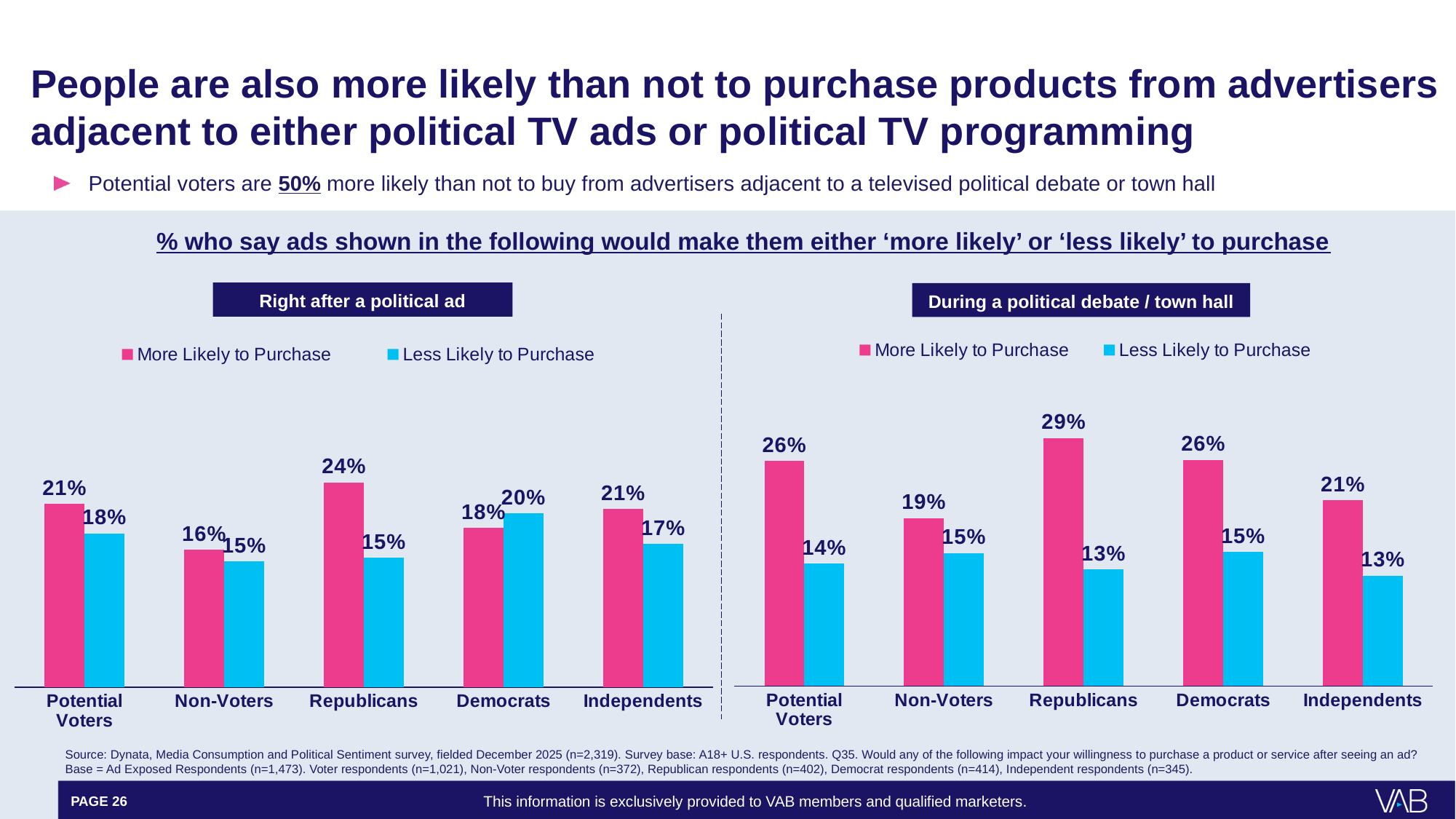
In the 'During a political debate / town hall' chart, what is the difference between the More Likely and Less Likely to Purchase values for Potential Voters? 12 percentage points In the 'During a political debate / town hall' chart, which category has the highest More Likely to Purchase value? Republicans In the 'Right after a political ad' chart, which is larger for Democrats: More Likely to Purchase or Less Likely to Purchase? Less Likely to Purchase In the 'Right after a political ad' chart, what percentage of Republicans are More Likely to Purchase? 24% In the 'Right after a political ad' chart, which category has the lowest More Likely to Purchase value? Non-Voters How many series does the legend of the 'During a political debate / town hall' chart list? 2 What type of chart is the 'Right after a political ad' chart? Bar chart In the 'During a political debate / town hall' chart, what is the difference between the More Likely to Purchase values for Republicans and Non-Voters? 10 percentage points In the 'Right after a political ad' chart, what is the Less Likely to Purchase value for Potential Voters? 18% How many categories are shown on the x axis of the 'Right after a political ad' chart? 5 In the 'During a political debate / town hall' chart, what percentage of Independents are Less Likely to Purchase? 13% What colour represents the 'More Likely to Purchase' series in both charts? Pink